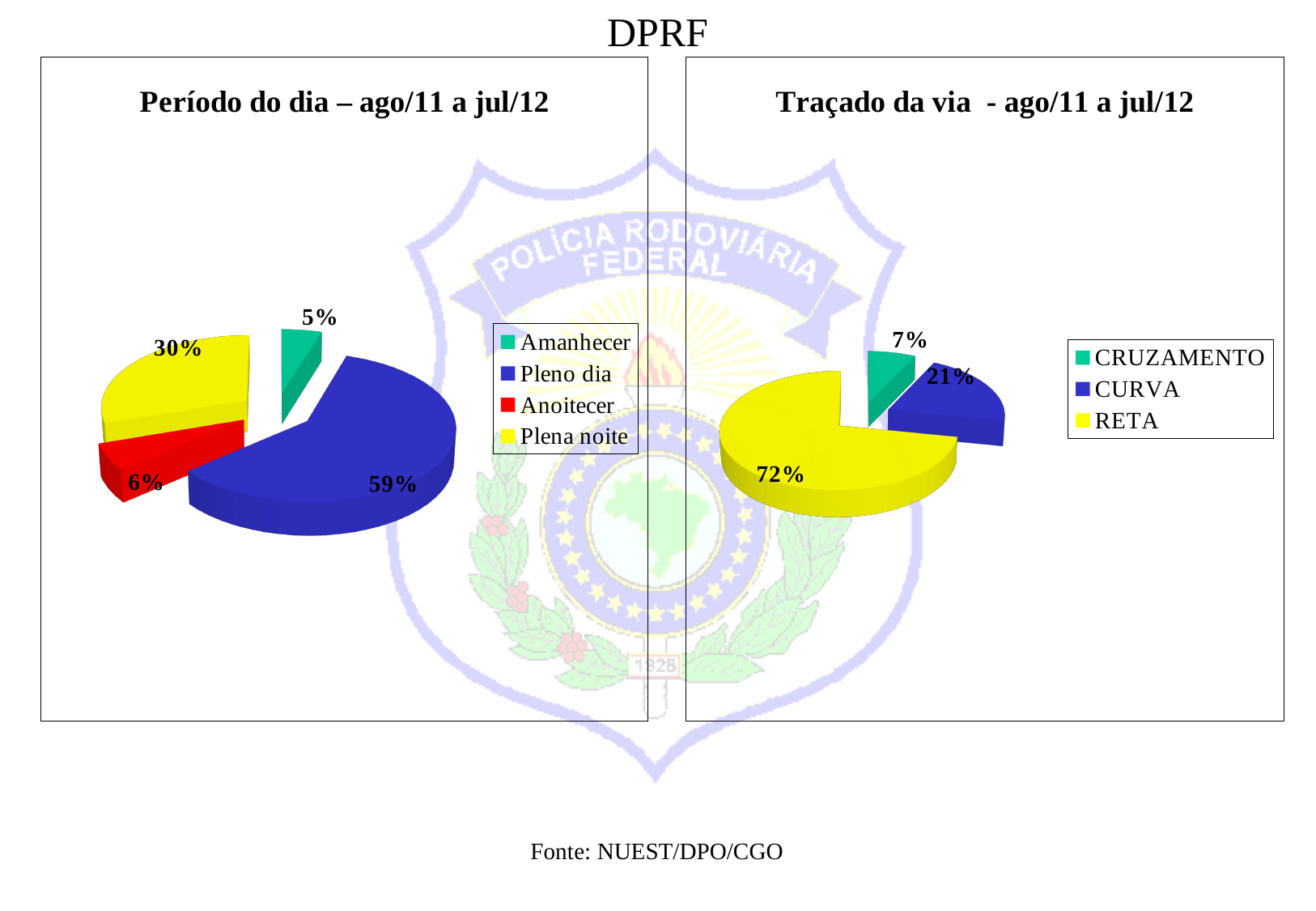
In the 'Período do dia – ago/11 a jul/12' chart, what share does Plena noite have? 30% What kind of chart is the 'Traçado da via - ago/11 a jul/12' chart? Pie chart In the 'Período do dia – ago/11 a jul/12' chart, how many categories does the legend list? 4 In the 'Período do dia – ago/11 a jul/12' chart, what share does Pleno dia have? 59% In the 'Período do dia – ago/11 a jul/12' chart, what is the value for Anoitecer? 6% In the 'Traçado da via - ago/11 a jul/12' chart, what share does RETA have? 72% In the 'Período do dia – ago/11 a jul/12' chart, which category has the smallest slice? Amanhecer In the 'Período do dia – ago/11 a jul/12' chart, which category has the largest slice? Pleno dia In the 'Período do dia – ago/11 a jul/12' chart, what is the difference between Pleno dia and Plena noite? 29% In the 'Traçado da via - ago/11 a jul/12' chart, what is the value for CURVA? 21% In the 'Traçado da via - ago/11 a jul/12' chart, which category has the smallest slice? CRUZAMENTO In the 'Traçado da via - ago/11 a jul/12' chart, which is larger, CURVA or CRUZAMENTO? CURVA